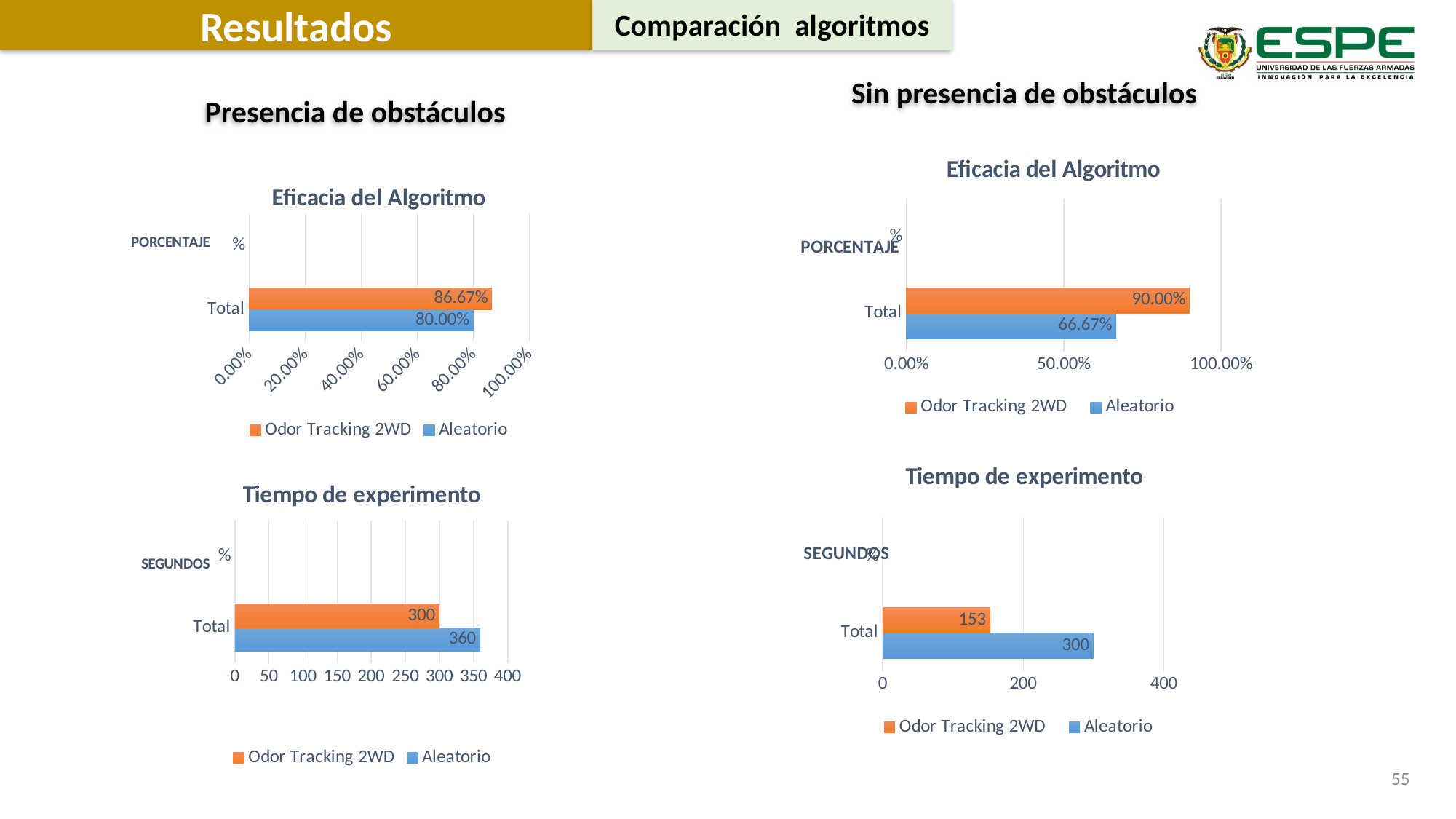
In the 'Eficacia del Algoritmo' chart under 'Sin presencia de obstáculos', what is the value for Odor Tracking 2WD? 90.00% How many series does the legend list in the 'Eficacia del Algoritmo' chart under 'Presencia de obstáculos'? 2 In the 'Tiempo de experimento' chart under 'Sin presencia de obstáculos', what is the difference between the Aleatorio and Odor Tracking 2WD values? 147 In the 'Eficacia del Algoritmo' chart under 'Sin presencia de obstáculos', which series has the higher value? Odor Tracking 2WD In the 'Eficacia del Algoritmo' chart under 'Sin presencia de obstáculos', what is the value for Aleatorio? 66.67% In the 'Tiempo de experimento' chart under 'Presencia de obstáculos', what is the difference between the Aleatorio and Odor Tracking 2WD values? 60 In the 'Eficacia del Algoritmo' chart under 'Presencia de obstáculos', what is the value for Aleatorio? 80.00% In the 'Eficacia del Algoritmo' chart under 'Presencia de obstáculos', what is the value for Odor Tracking 2WD? 86.67% In the 'Tiempo de experimento' chart under 'Presencia de obstáculos', what is the value for Aleatorio? 360 In the 'Tiempo de experimento' chart under 'Sin presencia de obstáculos', what is the value for Odor Tracking 2WD? 153 In the 'Tiempo de experimento' chart under 'Presencia de obstáculos', which series has the lower value? Odor Tracking 2WD What type of chart is the 'Tiempo de experimento' chart under 'Sin presencia de obstáculos'? Bar chart